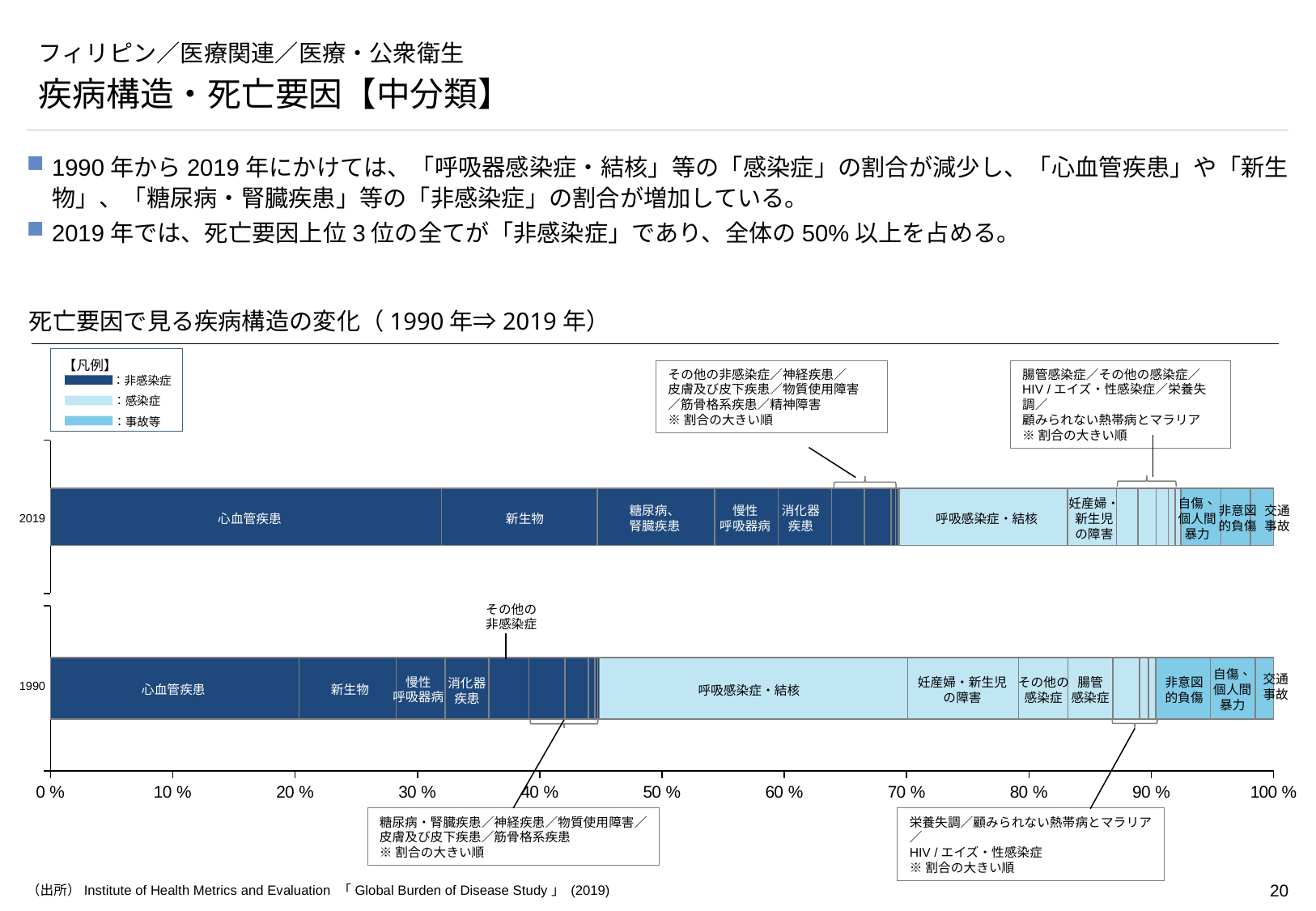
Which cause of death has the largest share in the 2019 bar? 心血管疾患 How many categories does the legend list? 3 How many years (bars) are plotted in the chart? 2 Which legend category is shown in dark blue? 非感染症 Which cause of death has the largest share in the 1990 bar? 呼吸器感染症・結核 Did the share of 心血管疾患 rise or fall from 1990 to 2019? rise In 1990, is the share of 心血管疾患 greater or less than 30%? less In 2019, is the share of 呼吸器感染症・結核 greater or less than 20%? less In 2019, is the share of 心血管疾患 greater or less than 20%? greater What kind of chart is used to show the change in disease structure by cause of death? Stacked bar chart In 2019, which has the larger share: 心血管疾患 or 新生物? 心血管疾患 Did the share of 呼吸器感染症・結核 rise or fall from 1990 to 2019? fall